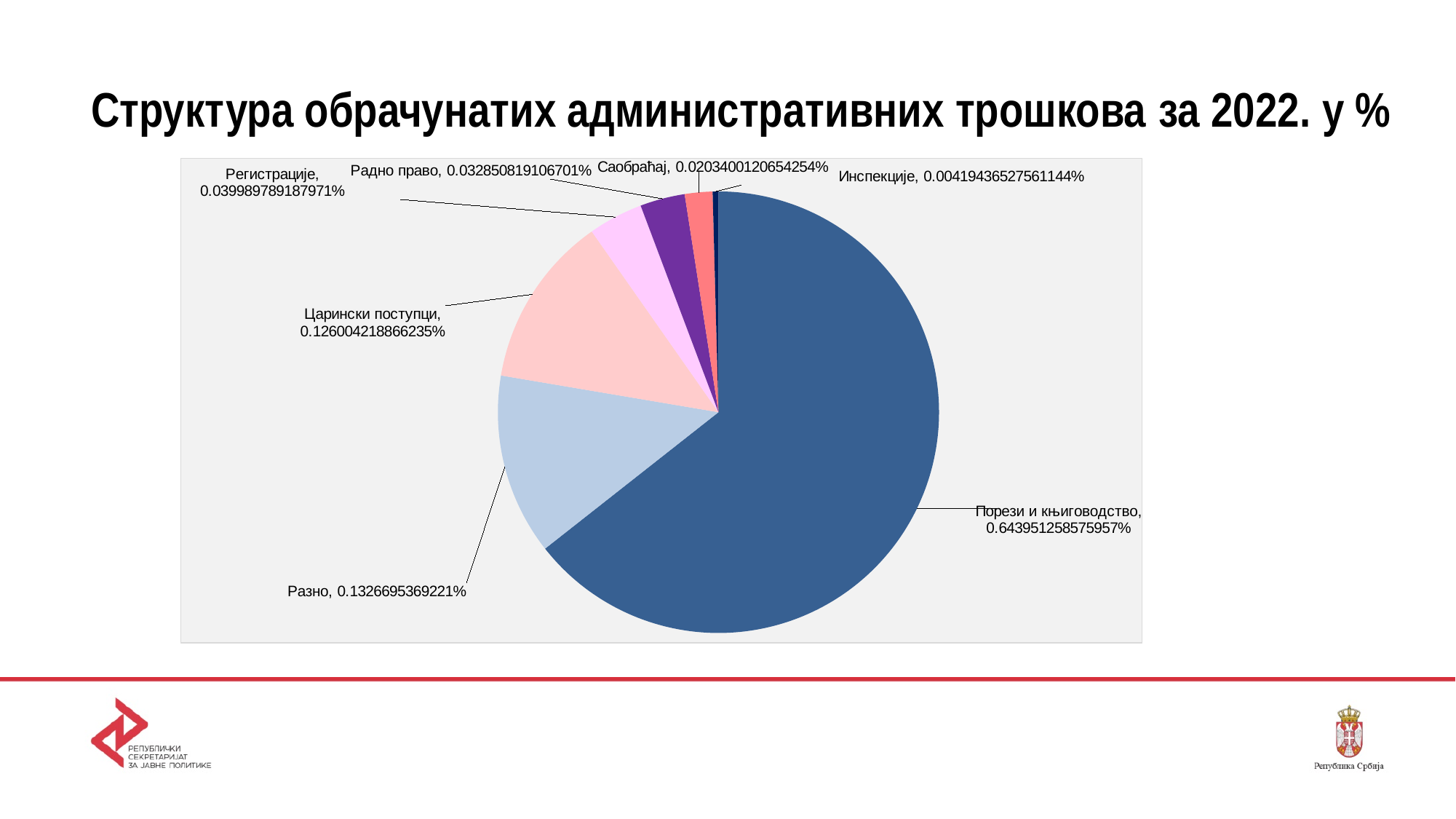
What is the value for Царински поступци? 0.126004218866235% Which is larger, Радно право or Саобраћај? Радно право Which category has the smallest slice of the pie? Инспекције What is the value for Регистрације? 0.039989789187971% What is the value for Разно? 0.1326695369221% What is the title of the chart? Структура обрачунатих административних трошкова за 2022. у % What is the value for Инспекције? 0.00419436527561144% What type of chart is shown on the slide? pie chart What is the difference between the values for Разно and Царински поступци? 0.006665318055865% Which category has the largest slice of the pie? Порези и књиговодство How many slices does the pie chart have? 7 What is the value for Порези и књиговодство? 0.643951258575957%